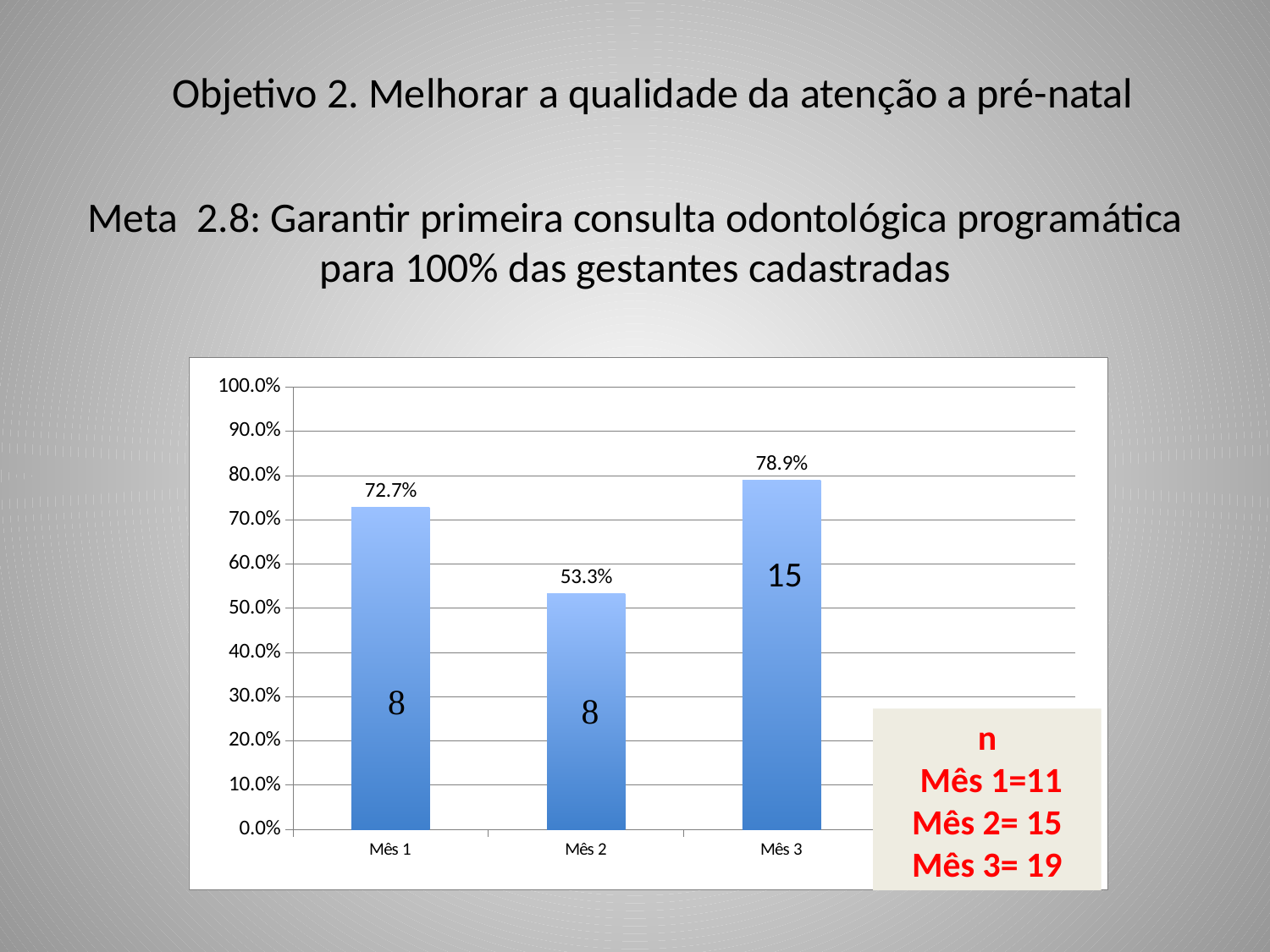
What is the value for Mês 3? 78.9% Which month has the lowest value? Mês 2 What is the difference between the values for Mês 3 and Mês 2? 25.6% Is the value for Mês 2 greater or less than 60.0%? less Which month has the highest value? Mês 3 What is the value for Mês 1? 72.7% According to the box on the slide, what is n for Mês 2? 15 Which is larger, the value for Mês 1 or the value for Mês 3? Mês 3 What is the value for Mês 2? 53.3% What kind of chart is shown on the slide? bar chart What number is printed inside the bar for Mês 3? 15 How many categories are shown on the x axis? 3